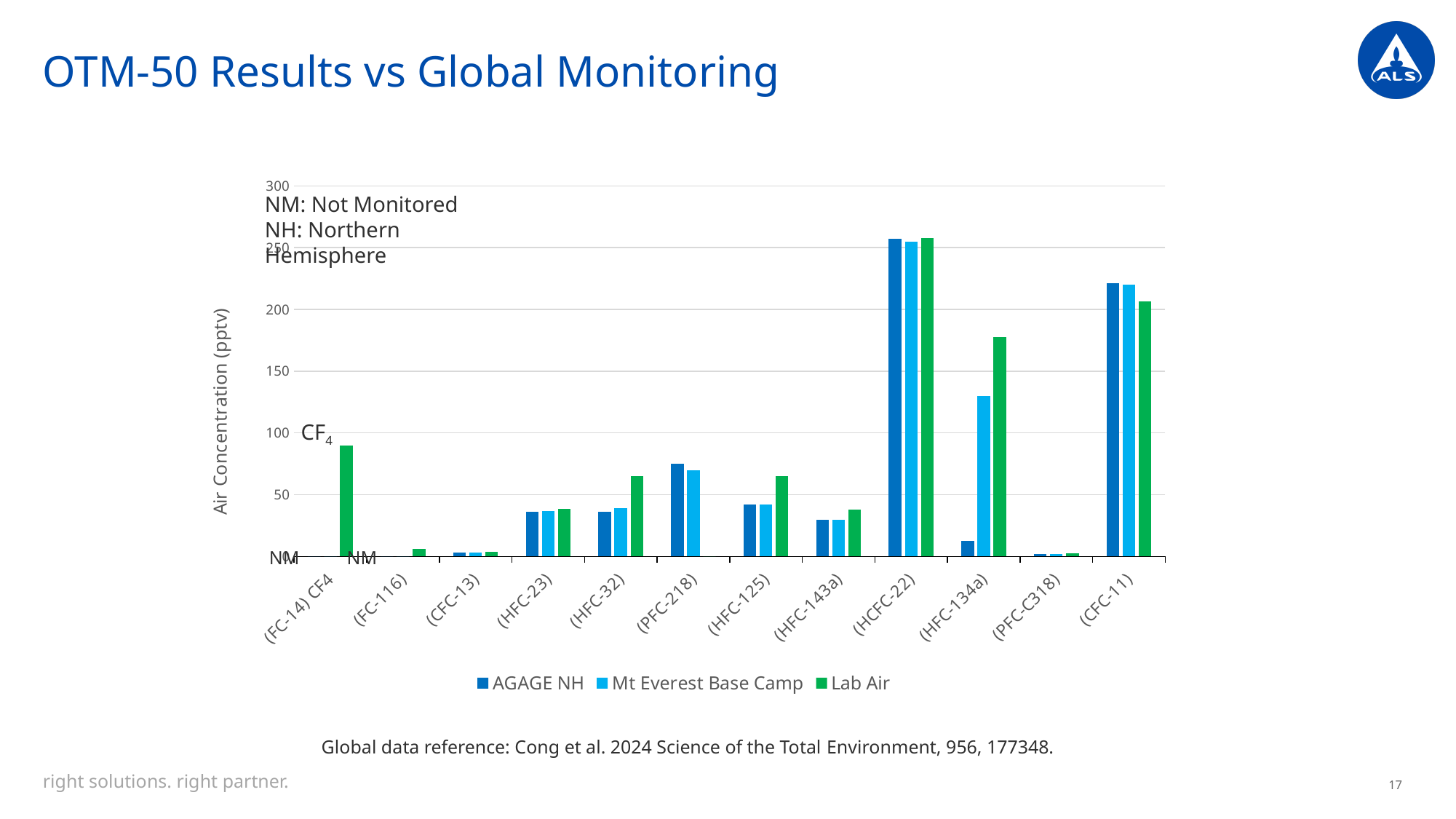
Which category has the highest AGAGE NH value? (HCFC-22) How many compound categories are shown on the x axis? 12 Is the Mt Everest Base Camp value for (HFC-134a) greater or less than 150? less Which category has the highest Lab Air value? (HCFC-22) How many series does the legend list? 3 For (HFC-32), which is larger: the Lab Air value or the Mt Everest Base Camp value? Lab Air Is the AGAGE NH value for (PFC-218) greater or less than 50? greater What kind of chart is shown on the slide? Bar chart What is the title of the y axis? Air Concentration (pptv) Is the Lab Air value for (HFC-134a) greater or less than 150? greater For (HFC-134a), which is larger: the Lab Air value or the AGAGE NH value? Lab Air According to the note on the chart, what does NM stand for? Not Monitored